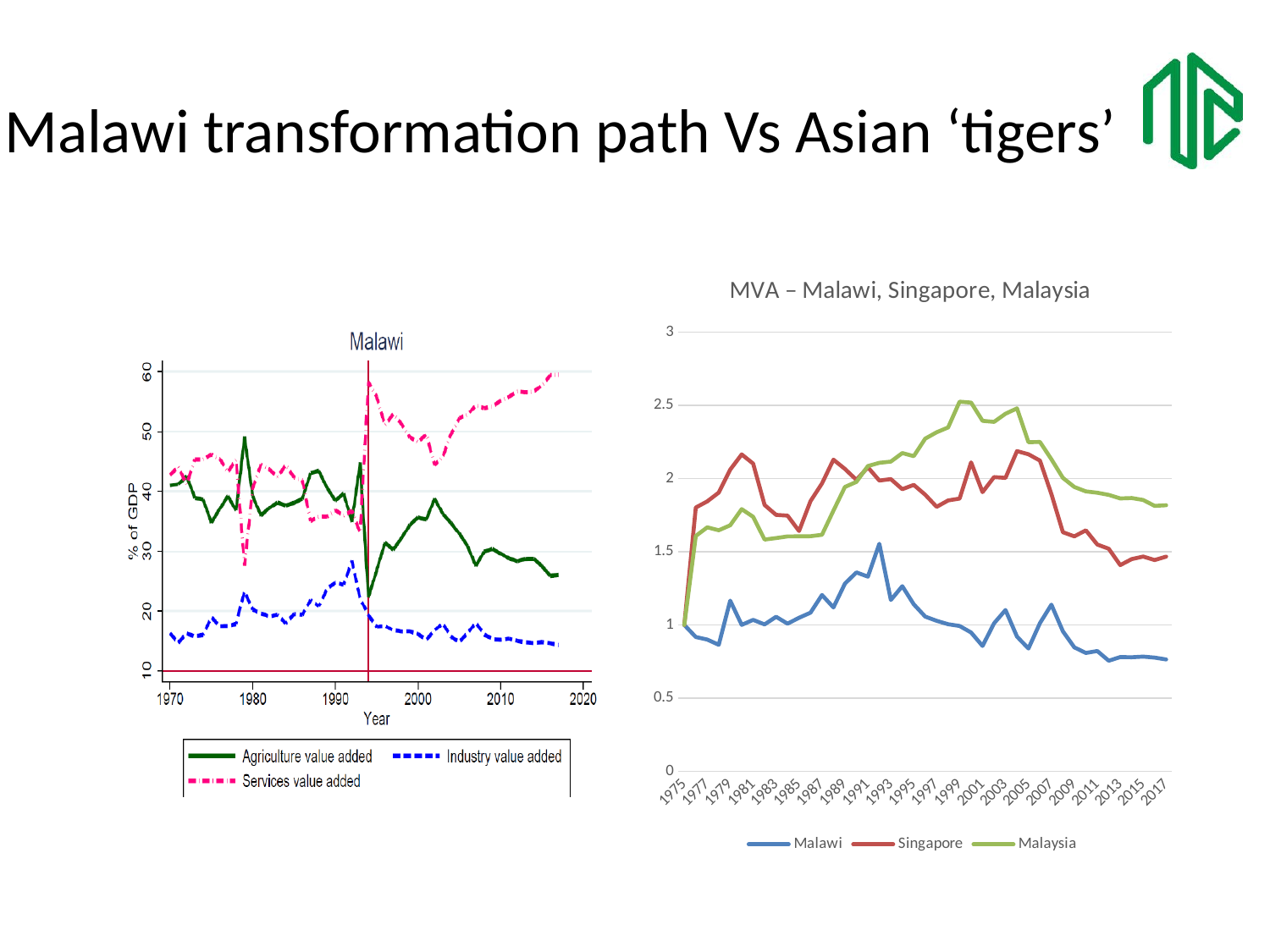
In the left 'Malawi' chart, is the value for Industry value added in 2017 greater or less than 20? less In the left 'Malawi' chart, does Agriculture value added rise or fall between 1995 and 2017? Fall In the left 'Malawi' chart, is the value for Services value added in 2017 greater or less than 50? greater How many series does the legend of the left 'Malawi' chart list? 3 How many series does the legend of the right chart 'MVA – Malawi, Singapore, Malaysia' list? 3 In the left 'Malawi' chart, is the value for Agriculture value added in 2017 greater or less than 30? less What is the y-axis label of the left 'Malawi' chart? % of GDP What kind of chart is the left chart titled 'Malawi'? Line chart In the left 'Malawi' chart, which is larger in 2017: Services value added or Agriculture value added? Services value added In the right chart 'MVA – Malawi, Singapore, Malaysia', which series has the highest value around 2000? Malaysia In the right chart 'MVA – Malawi, Singapore, Malaysia', does the Malawi line rise or fall between 2007 and 2017? Fall